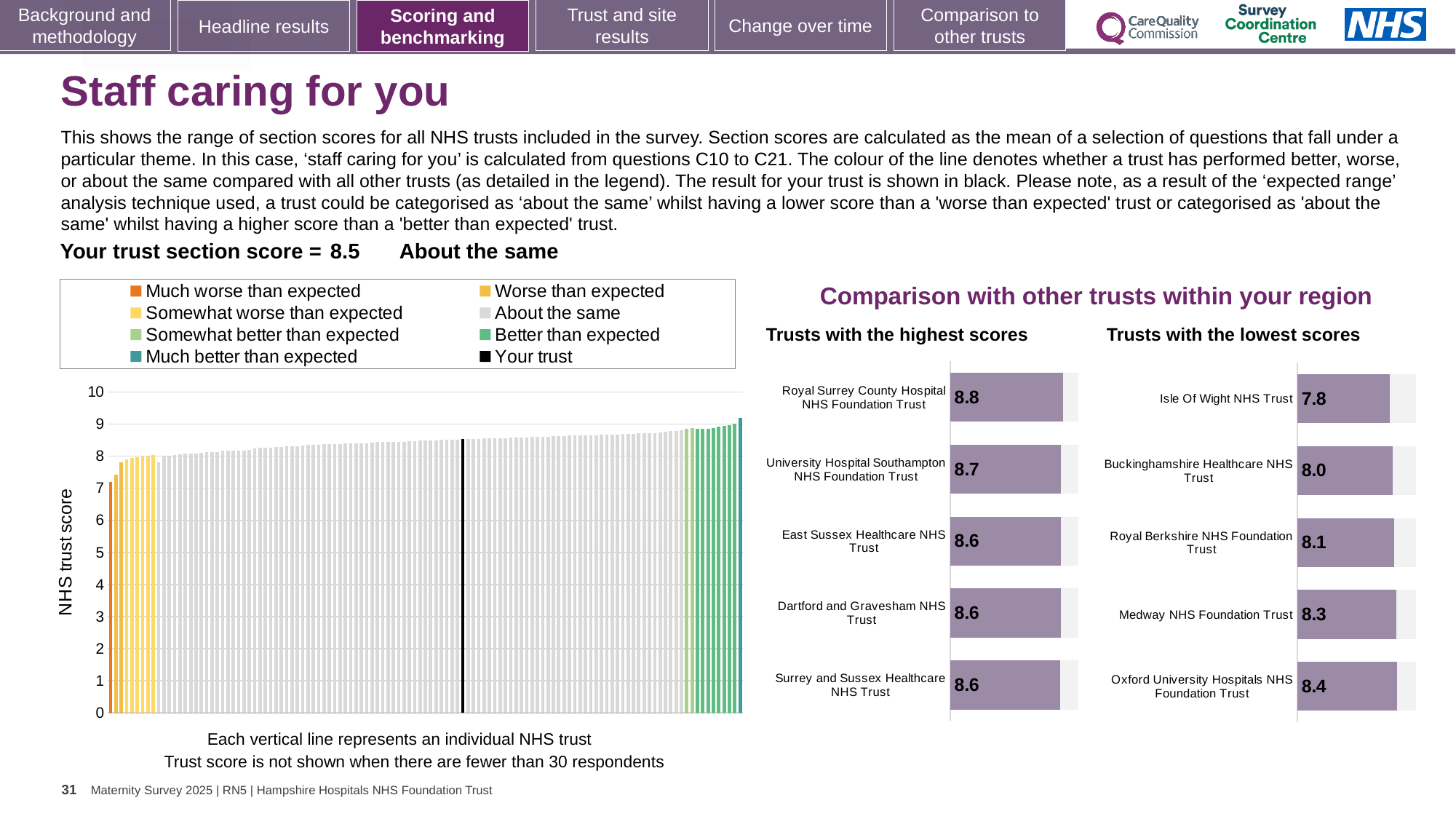
What kind of chart is the 'NHS trust score' chart on the left of the slide? Bar chart In the 'Trusts with the lowest scores' chart, what is the score for Isle Of Wight NHS Trust? 7.8 In the 'Trusts with the lowest scores' chart, which trust has the lowest score? Isle Of Wight NHS Trust In the 'Trusts with the highest scores' chart, what is the score for Royal Surrey County Hospital NHS Foundation Trust? 8.8 How many trusts are shown in the 'Trusts with the lowest scores' chart? 5 In the 'NHS trust score' chart on the left, do the bars rise or fall from left to right? Rise In the 'Trusts with the lowest scores' chart, what is the score for Medway NHS Foundation Trust? 8.3 In the 'Trusts with the highest scores' chart, which trust has the highest score? Royal Surrey County Hospital NHS Foundation Trust How many entries does the legend above the 'NHS trust score' chart list? 8 What is the difference between the score for Royal Surrey County Hospital NHS Foundation Trust in the highest scores chart and Isle Of Wight NHS Trust in the lowest scores chart? 1.0 In the 'Trusts with the highest scores' chart, what is the score for University Hospital Southampton NHS Foundation Trust? 8.7 In the 'Trusts with the lowest scores' chart, which has the larger score: Buckinghamshire Healthcare NHS Trust or Oxford University Hospitals NHS Foundation Trust? Oxford University Hospitals NHS Foundation Trust